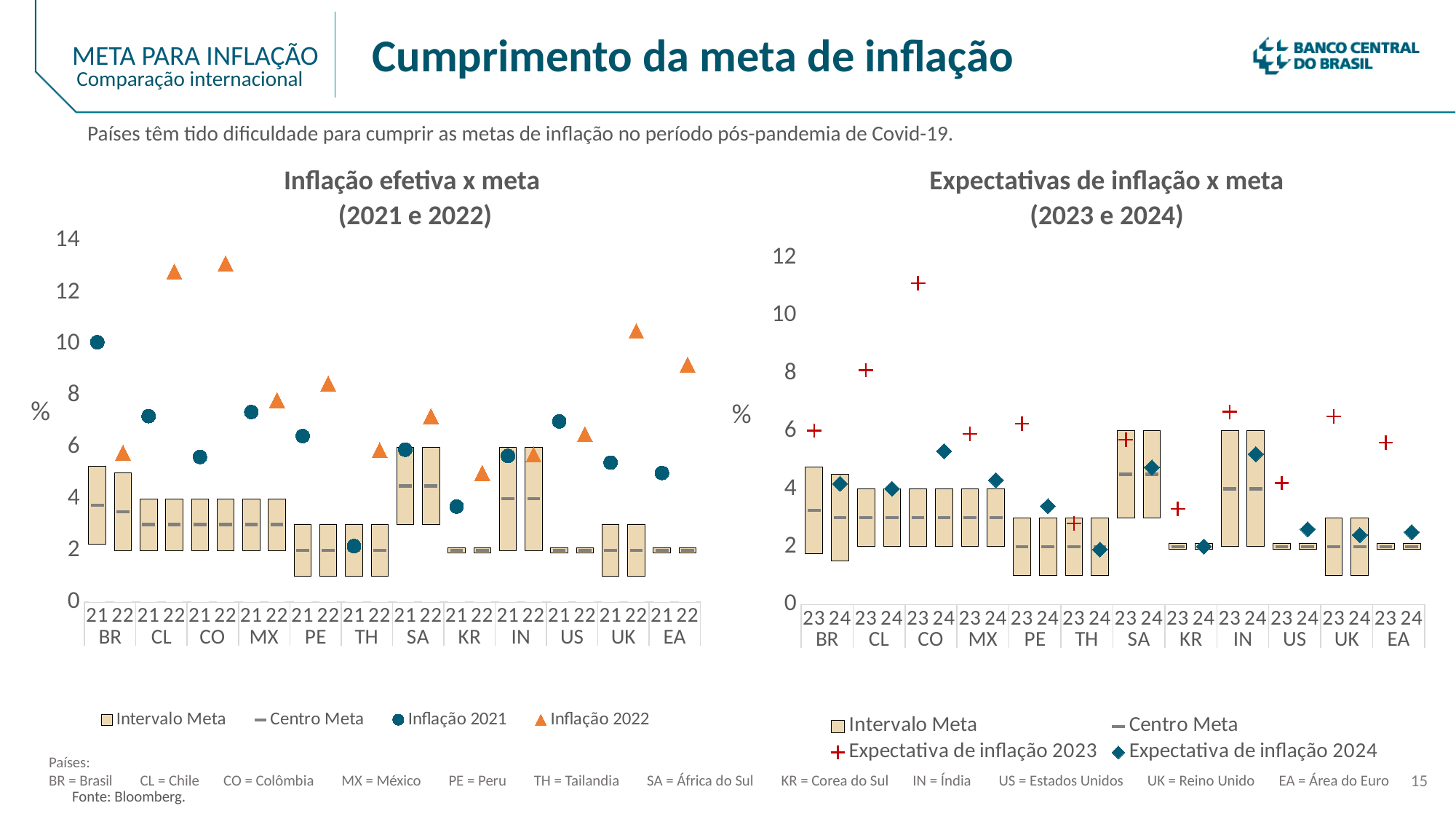
In the right chart 'Expectativas de inflação x meta (2023 e 2024)', which country has the highest Expectativa de inflação 2023 value? CO In the left chart 'Inflação efetiva x meta (2021 e 2022)', is the Inflação 2021 value for KR greater or less than 4? less What is the title of the chart on the right side of the slide? Expectativas de inflação x meta (2023 e 2024) How many series does the legend of the left chart 'Inflação efetiva x meta (2021 e 2022)' list? 4 In the right chart 'Expectativas de inflação x meta (2023 e 2024)', which is larger for BR: Expectativa de inflação 2023 or Expectativa de inflação 2024? Expectativa de inflação 2023 In the right chart 'Expectativas de inflação x meta (2023 e 2024)', is the Expectativa de inflação 2023 value for CO greater or less than 10? greater In the left chart 'Inflação efetiva x meta (2021 e 2022)', which country has the lowest Inflação 2021 value? TH In the left chart 'Inflação efetiva x meta (2021 e 2022)', which is larger for CL: Inflação 2021 or Inflação 2022? Inflação 2022 In the left chart 'Inflação efetiva x meta (2021 e 2022)', is the Inflação 2021 value for BR greater or less than 8? greater In the left chart 'Inflação efetiva x meta (2021 e 2022)', which country has the highest Inflação 2021 value? BR How many countries are shown on the x axis of the left chart 'Inflação efetiva x meta (2021 e 2022)'? 12